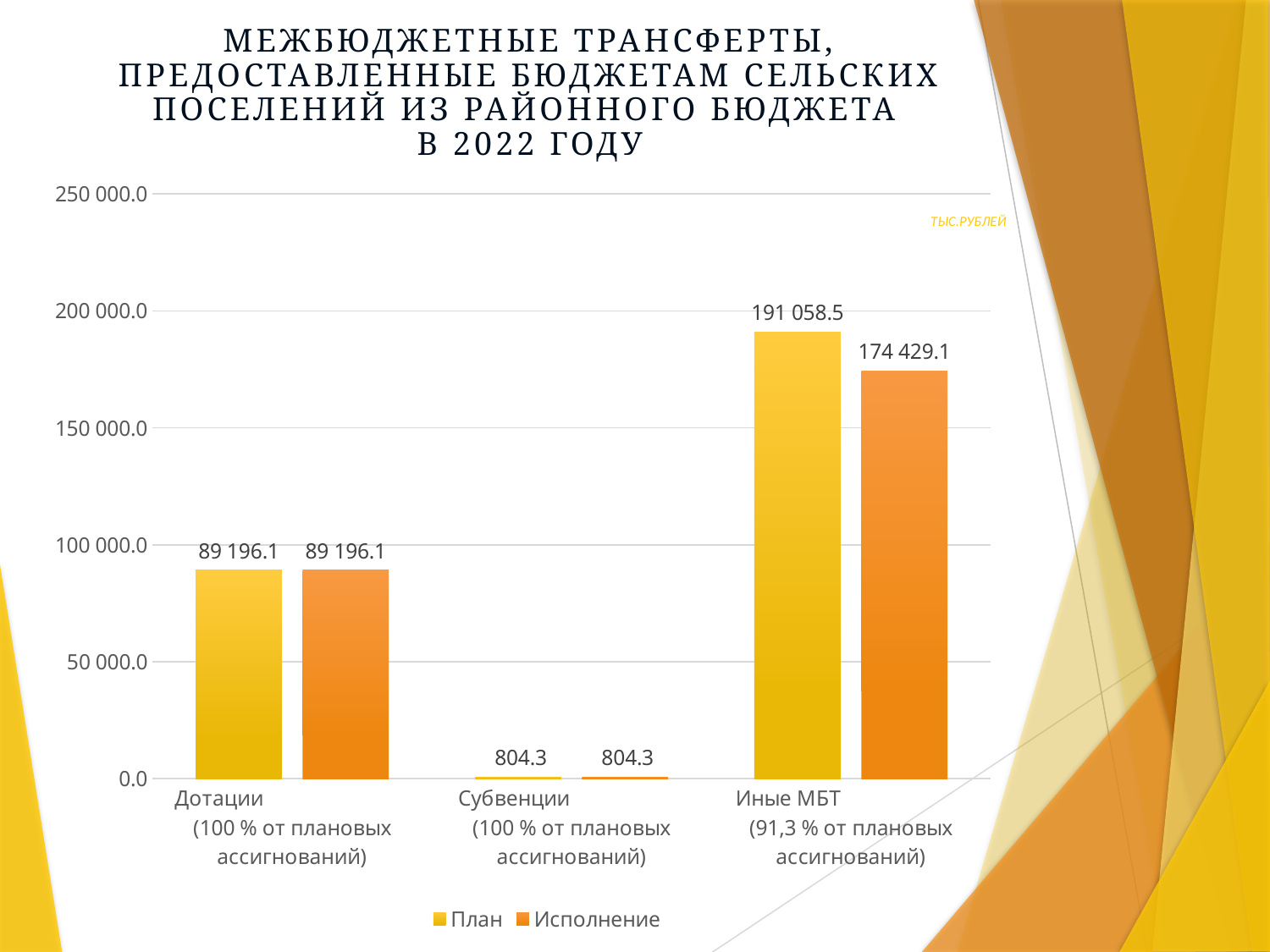
Which is larger for Иные МБТ, the План value or the Исполнение value? План What is the difference between the План and Исполнение values for Иные МБТ? 16 629.4 What is the План value for Субвенции? 804.3 Which category has the lowest Исполнение value? Субвенции What is the План value for Дотации? 89 196.1 What kind of chart is shown on the slide? bar chart What is the Исполнение value for Иные МБТ? 174 429.1 Is the Исполнение value for Дотации greater or less than 100 000.0? less How many series does the legend list? 2 What unit is indicated in the label at the top right of the chart? ТЫС.РУБЛЕЙ Which category has the highest План value? Иные МБТ How many categories are shown on the x axis? 3